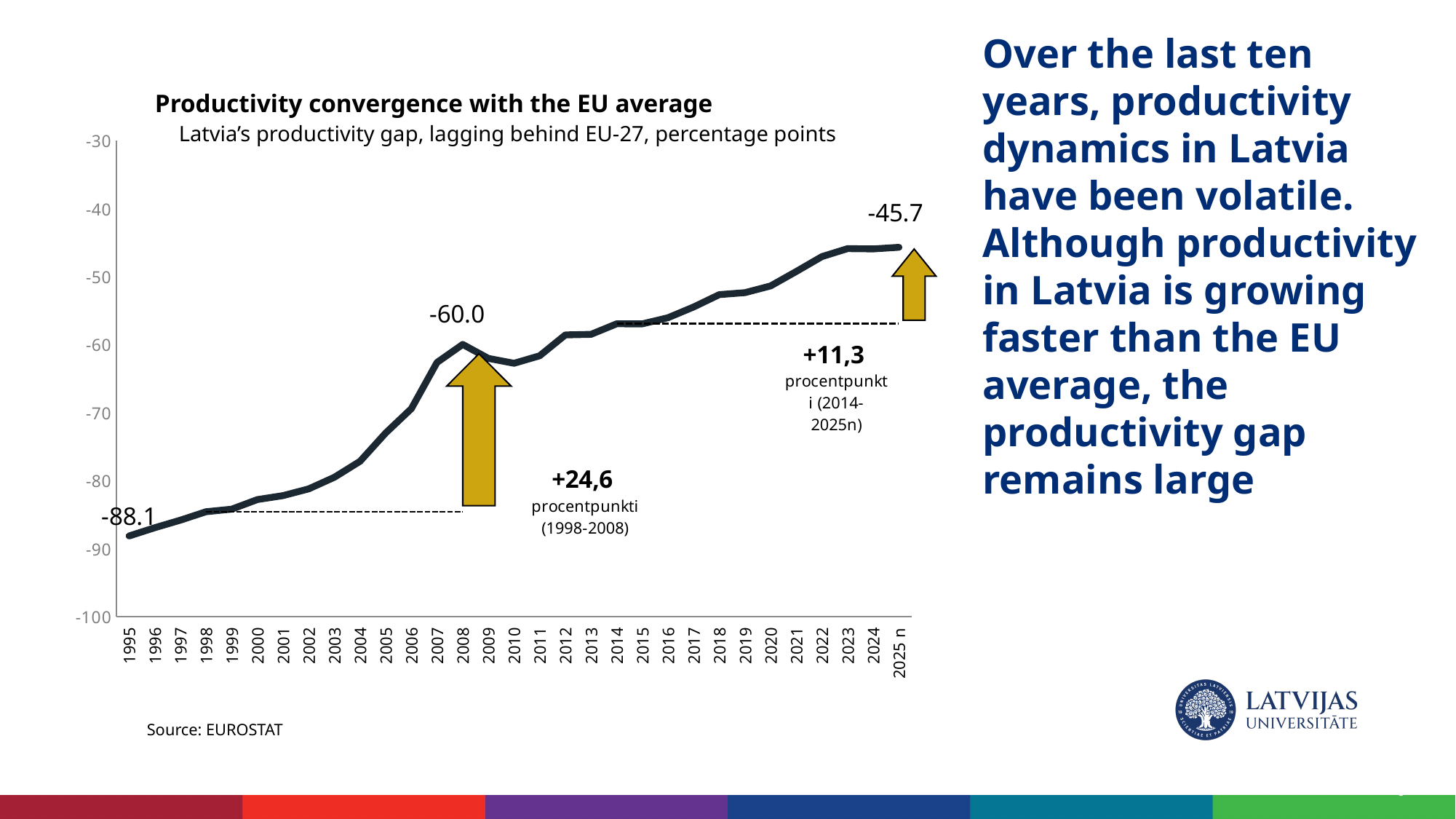
Does the line generally rise or fall from 1995 to 2025n? rise Which year has the higher (less negative) value, 2008 or 2025n? 2025n What is Latvia's productivity gap value for 2008? -60.0 What kind of chart is shown on the slide? line chart What is Latvia's productivity gap value for 1995? -88.1 By how many percentage points did the gap value change between 1995 (-88.1) and 2008 (-60.0)? 28.1 Which year has the lowest (most negative) value on the chart? 1995 Is the value for 2020 greater or less than -60? greater By how many percentage points did the gap value change between 2008 (-60.0) and 2025n (-45.7)? 14.3 What is Latvia's productivity gap value for 2025n? -45.7 Is the value for 2005 greater or less than -70? less What is the title of the chart? Productivity convergence with the EU average